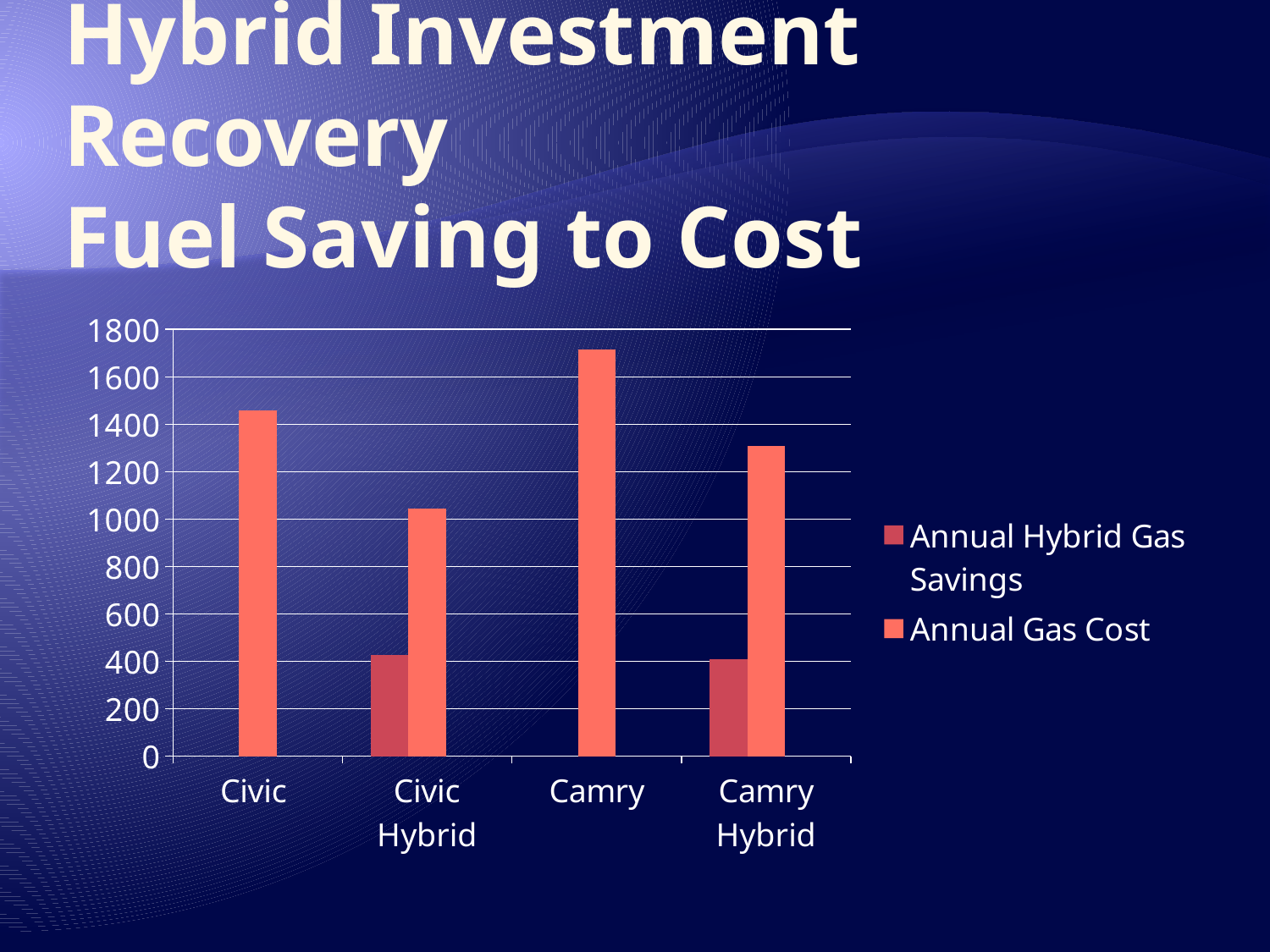
Which vehicles have no Annual Hybrid Gas Savings bar? Civic and Camry Is the Annual Gas Cost for Civic greater or less than 1200? greater Is the Annual Gas Cost for Camry greater or less than 1600? greater Is the Annual Hybrid Gas Savings for Civic Hybrid greater or less than 600? less Which vehicle has the highest Annual Gas Cost? Camry Which vehicle has the lowest Annual Gas Cost? Civic Hybrid How many series does the legend list? 2 Which is larger, the Annual Gas Cost for Camry Hybrid or the Annual Hybrid Gas Savings for Camry Hybrid? Annual Gas Cost How many vehicle categories are shown on the x axis? 4 What kind of chart is shown on the slide? bar chart Which is larger, the Annual Gas Cost for Civic or for Civic Hybrid? Civic